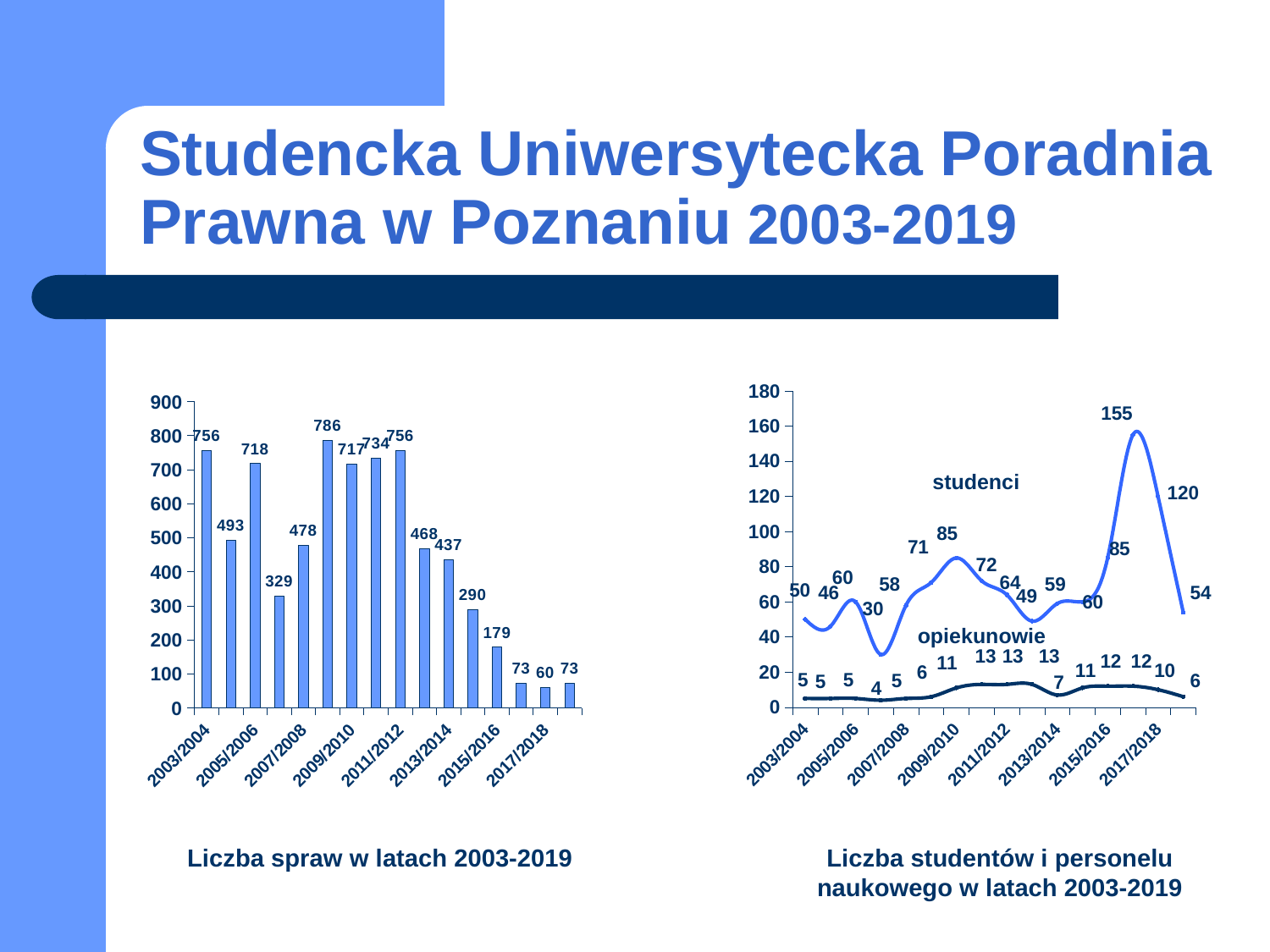
How many series are plotted in the right chart 'Liczba studentów i personelu naukowego w latach 2003-2019'? 2 In the right chart 'Liczba studentów i personelu naukowego w latach 2003-2019', what is the lowest value of the 'opiekunowie' series? 4 How many bars are there in the left chart 'Liczba spraw w latach 2003-2019'? 16 In the left chart 'Liczba spraw w latach 2003-2019', what is the difference between the value for 2003/2004 and the value for 2017/2018? 696 In the left chart 'Liczba spraw w latach 2003-2019', what is the value for 2003/2004? 756 In the left chart 'Liczba spraw w latach 2003-2019', what is the highest value shown? 786 In the right chart 'Liczba studentów i personelu naukowego w latach 2003-2019', what is the highest value of the 'studenci' series? 155 What kind of chart is the left chart, 'Liczba spraw w latach 2003-2019'? bar chart What kind of chart is the right chart, 'Liczba studentów i personelu naukowego w latach 2003-2019'? line chart In the left chart 'Liczba spraw w latach 2003-2019', what is the lowest value shown? 60 In the left chart 'Liczba spraw w latach 2003-2019', do the values rise or fall from 2011/2012 to 2017/2018? fall In the left chart 'Liczba spraw w latach 2003-2019', what is the value for 2015/2016? 179